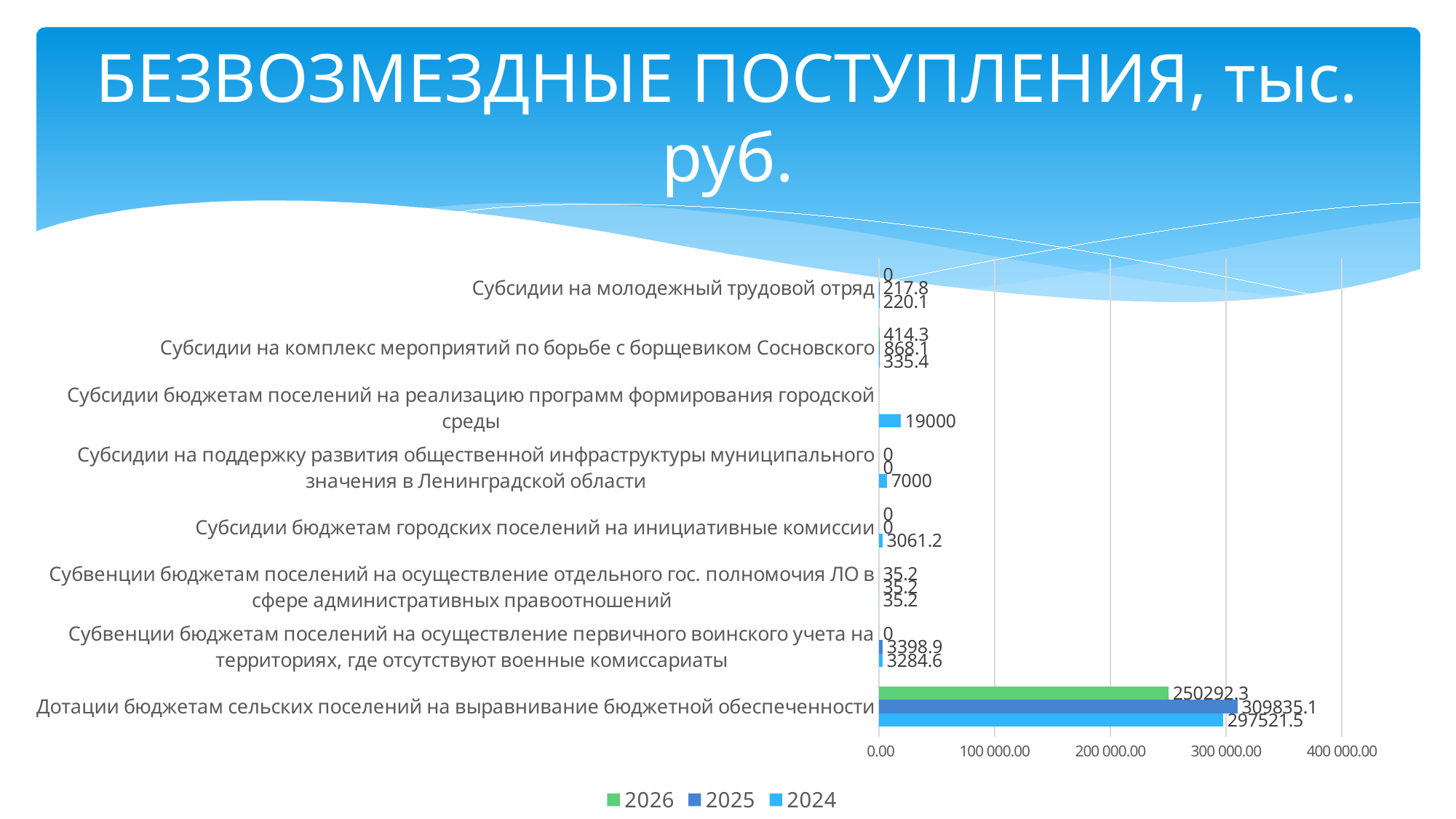
For Субвенции бюджетам поселений на осуществление первичного воинского учета на территориях, где отсутствуют военные комиссариаты, which is larger: the 2025 value or the 2024 value? 2025 Which colour represents the 2026 series in the legend? green What is the 2024 value for Субсидии бюджетам городских поселений на инициативные комиссии? 3061.2 What is the 2025 value for Субсидии на комплекс мероприятий по борьбе с борщевиком Сосновского? 868.1 How many categories are shown on the chart? 8 What is the 2024 value for Субсидии бюджетам поселений на реализацию программ формирования городской среды? 19000 What kind of chart is shown on the slide? bar chart Which category has the highest value in the 2024 series? Дотации бюджетам сельских поселений на выравнивание бюджетной обеспеченности What is the 2026 value for Дотации бюджетам сельских поселений на выравнивание бюджетной обеспеченности? 250292.3 What is the 2025 value for Дотации бюджетам сельских поселений на выравнивание бюджетной обеспеченности? 309835.1 How many series does the legend list? 3 What is the difference between the 2025 and 2024 values for Дотации бюджетам сельских поселений на выравнивание бюджетной обеспеченности? 12313.6